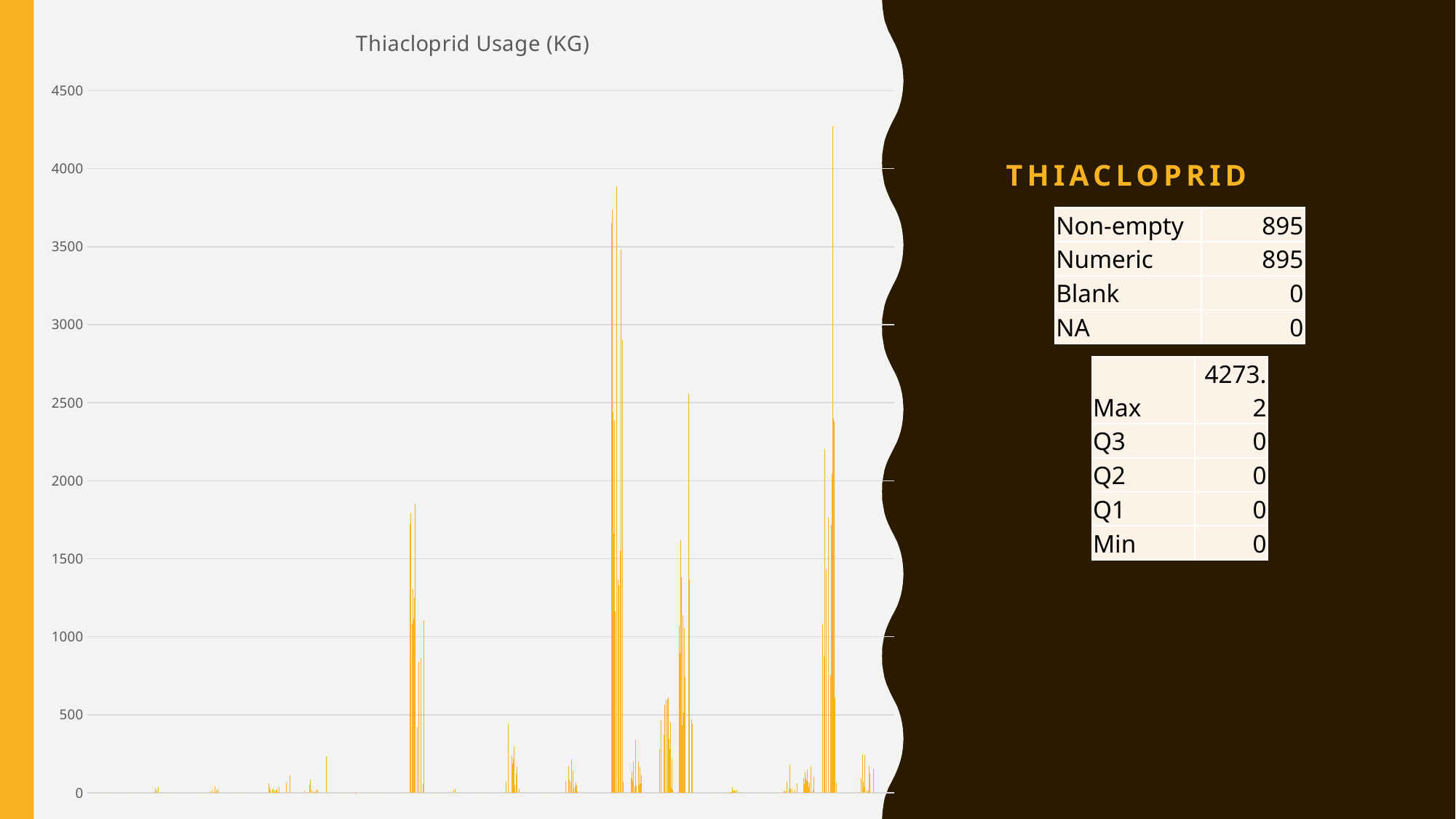
Is the value of the tallest bar in the chart greater or less than 4500? less What is the highest value labelled on the chart's vertical axis? 4500 What is the title of the chart? Thiacloprid Usage (KG) Is the value of the tallest bar in the chart greater or less than 4000? greater What kind of chart is shown on the slide? bar chart